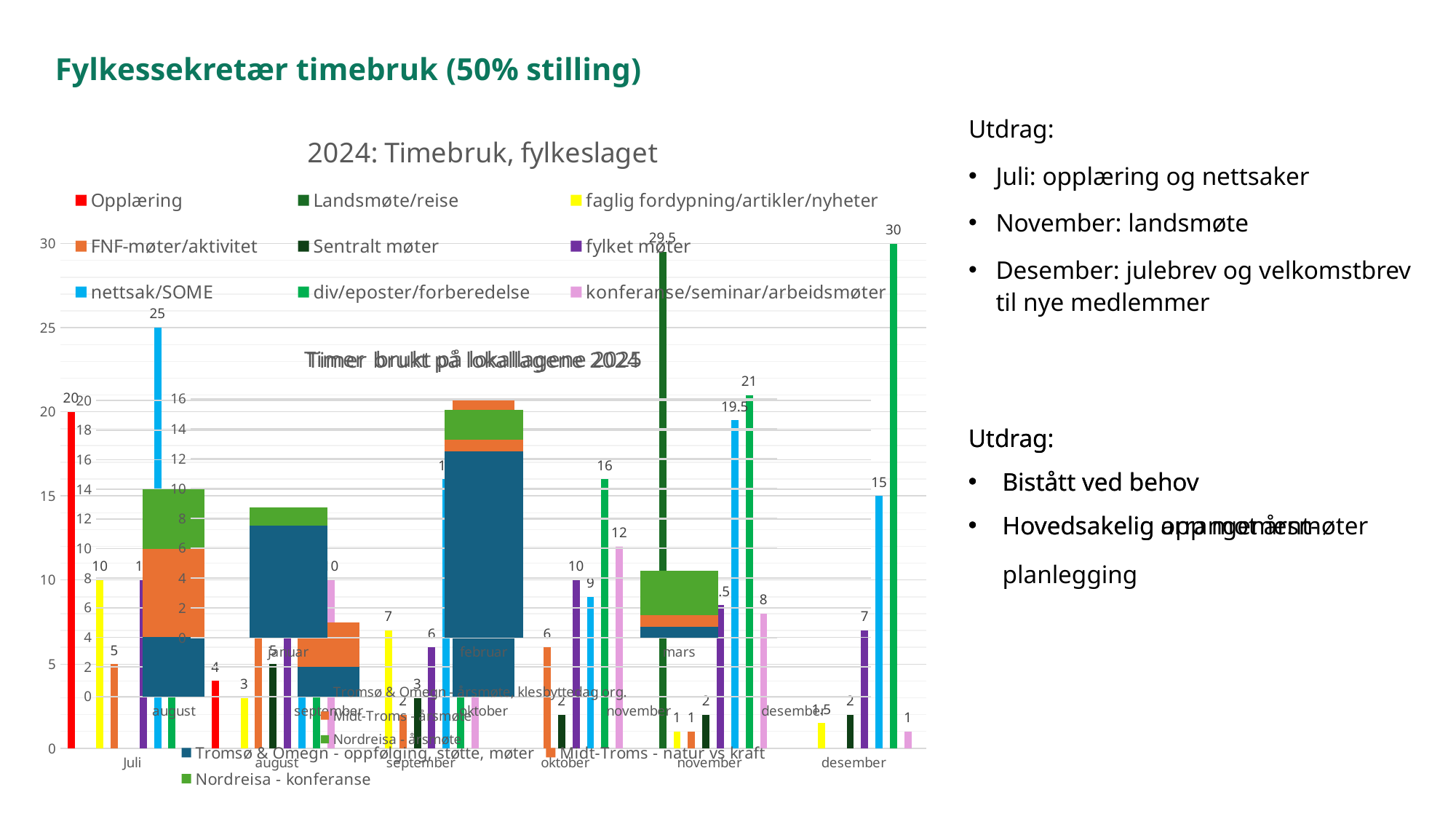
In the chart titled '2024: Timebruk, fylkeslaget', what is the value for nettsak/SOME in november? 19.5 In the chart titled '2024: Timebruk, fylkeslaget', which is larger: Landsmøte/reise in november or nettsak/SOME in Juli? Landsmøte/reise in november In the chart titled '2024: Timebruk, fylkeslaget', which series has the highest single bar across all months? div/eposter/forberedelse In the chart titled '2024: Timebruk, fylkeslaget', what is the value for div/eposter/forberedelse in desember? 30 In the chart titled '2024: Timebruk, fylkeslaget', what is the value for nettsak/SOME in Juli? 25 In the chart titled '2024: Timebruk, fylkeslaget', how many months are shown on the x axis? 6 In the chart titled '2024: Timebruk, fylkeslaget', how many series does the legend list? 9 In the chart titled '2024: Timebruk, fylkeslaget', what kind of chart is shown? bar chart In the chart titled '2024: Timebruk, fylkeslaget', what is the value for Landsmøte/reise in november? 29.5 In the chart titled '2024: Timebruk, fylkeslaget', what is the difference between nettsak/SOME in november and nettsak/SOME in desember? 4.5 In the chart titled '2024: Timebruk, fylkeslaget', what is the value for Opplæring in Juli? 20